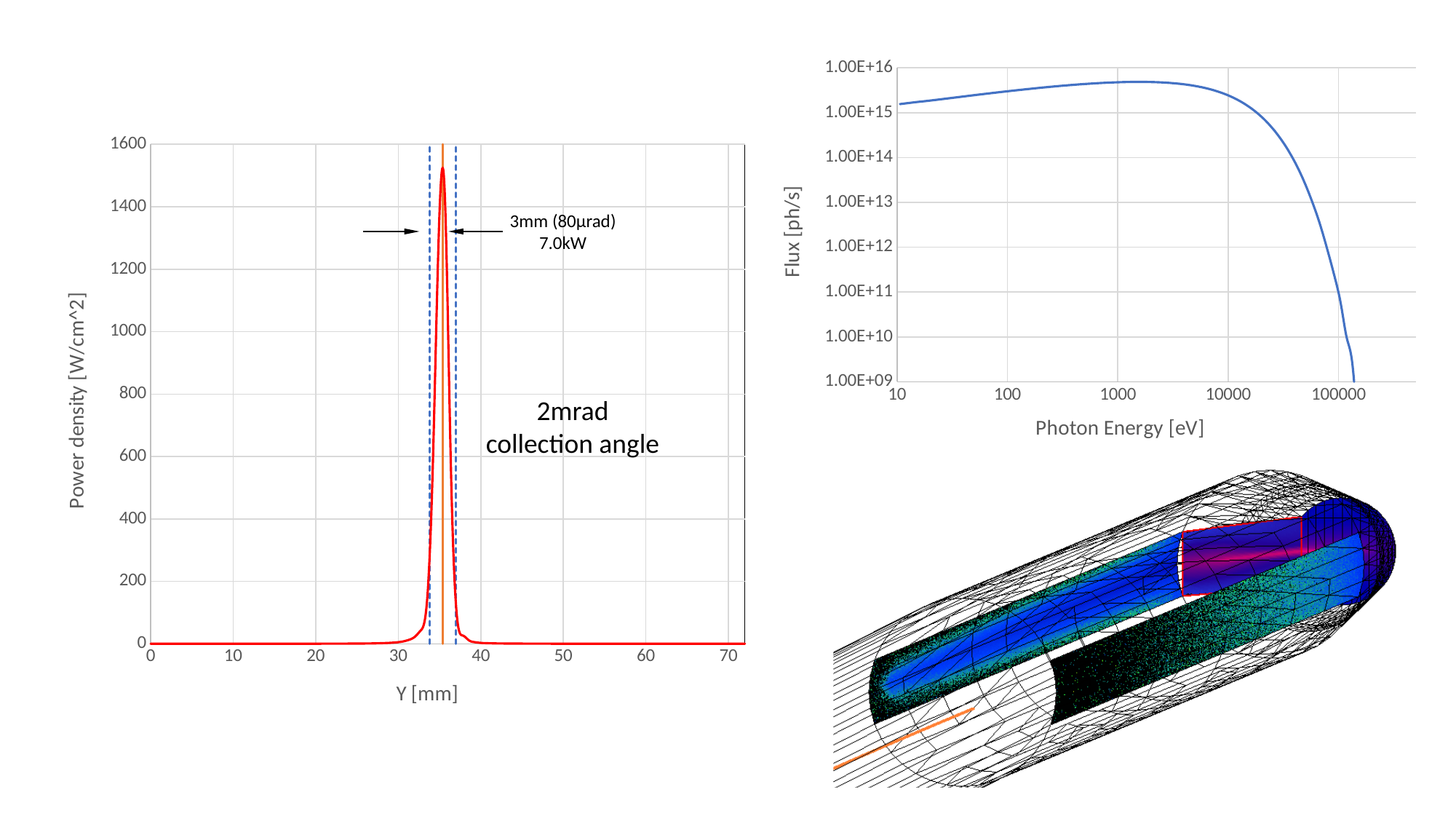
In the top-right chart, is the flux at 10000 eV greater or less than 1.00E+14? greater In the top-right chart, what is the label of the x axis? Photon Energy [eV] In the left chart, what collection angle is stated in the text annotation? 2mrad In the left chart, is the power density at Y = 10 mm greater or less than 200? less In the left chart, what power is stated in the annotation next to the 3mm (80µrad) width marker? 7.0kW In the left chart, is the peak power density greater or less than 1400? greater What kind of chart is the left chart showing power density versus Y [mm]? line chart In the top-right chart, does the flux rise or fall as photon energy increases from 10000 eV to 100000 eV? fall In the left chart, what is the label of the y axis? Power density [W/cm^2] What kind of chart is the top-right chart showing flux versus photon energy? line chart